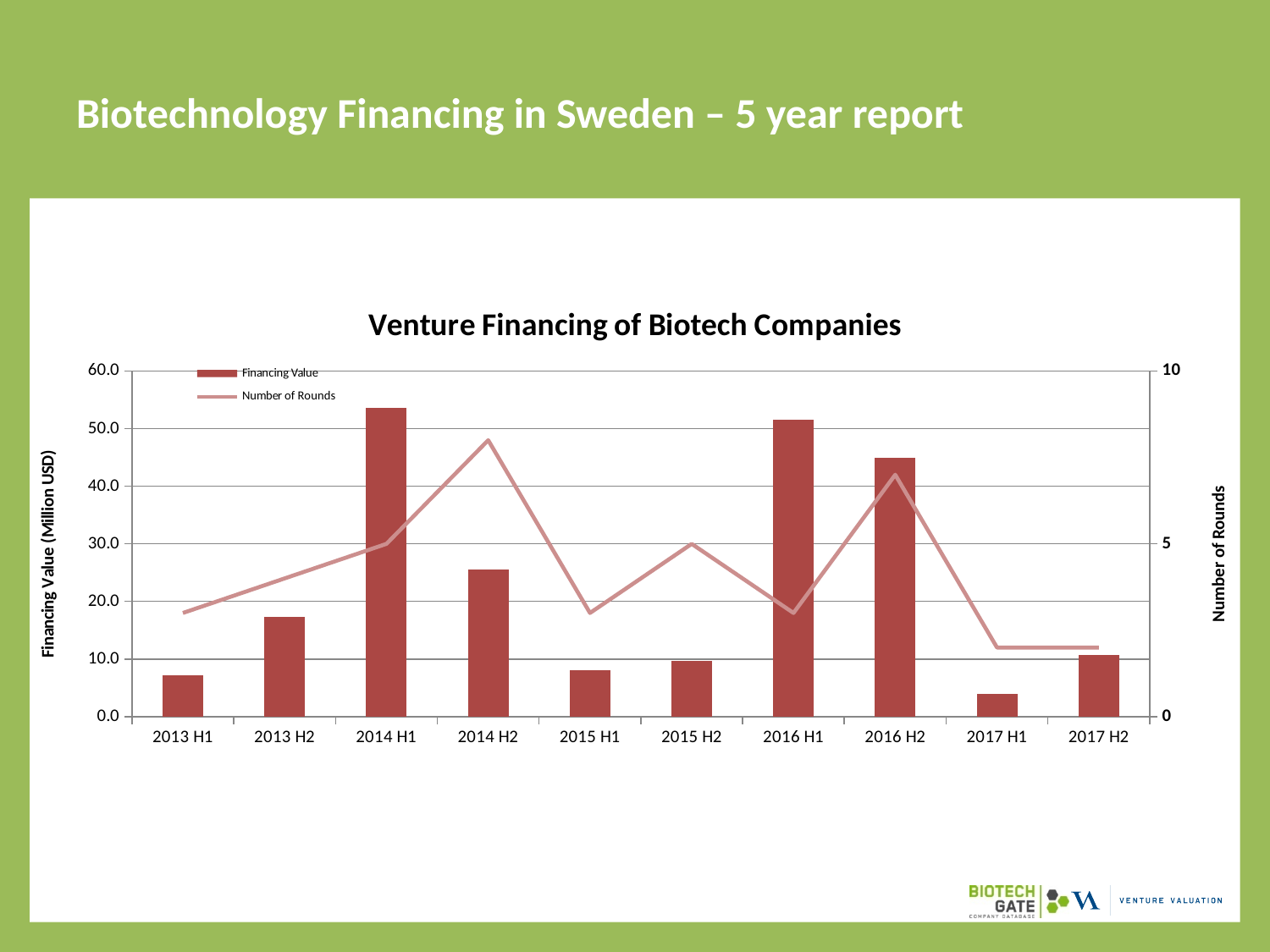
How many periods are shown along the x axis of the chart? 10 What kind of chart is used to show the Financing Value series? Bar chart Is the Financing Value for 2016 H2 greater or less than 40.0? greater What is the title of the chart? Venture Financing of Biotech Companies What is the label of the left vertical axis? Financing Value (Million USD) Which has the larger Financing Value, 2013 H1 or 2013 H2? 2013 H2 Is the Financing Value for 2014 H1 greater or less than 50.0? greater Which period has the lowest Financing Value bar? 2017 H1 Which period has the highest Number of Rounds? 2014 H2 Is the Financing Value for 2017 H1 greater or less than 10.0? less How many series does the chart legend list? 2 Which has the larger Financing Value, 2016 H1 or 2014 H2? 2016 H1